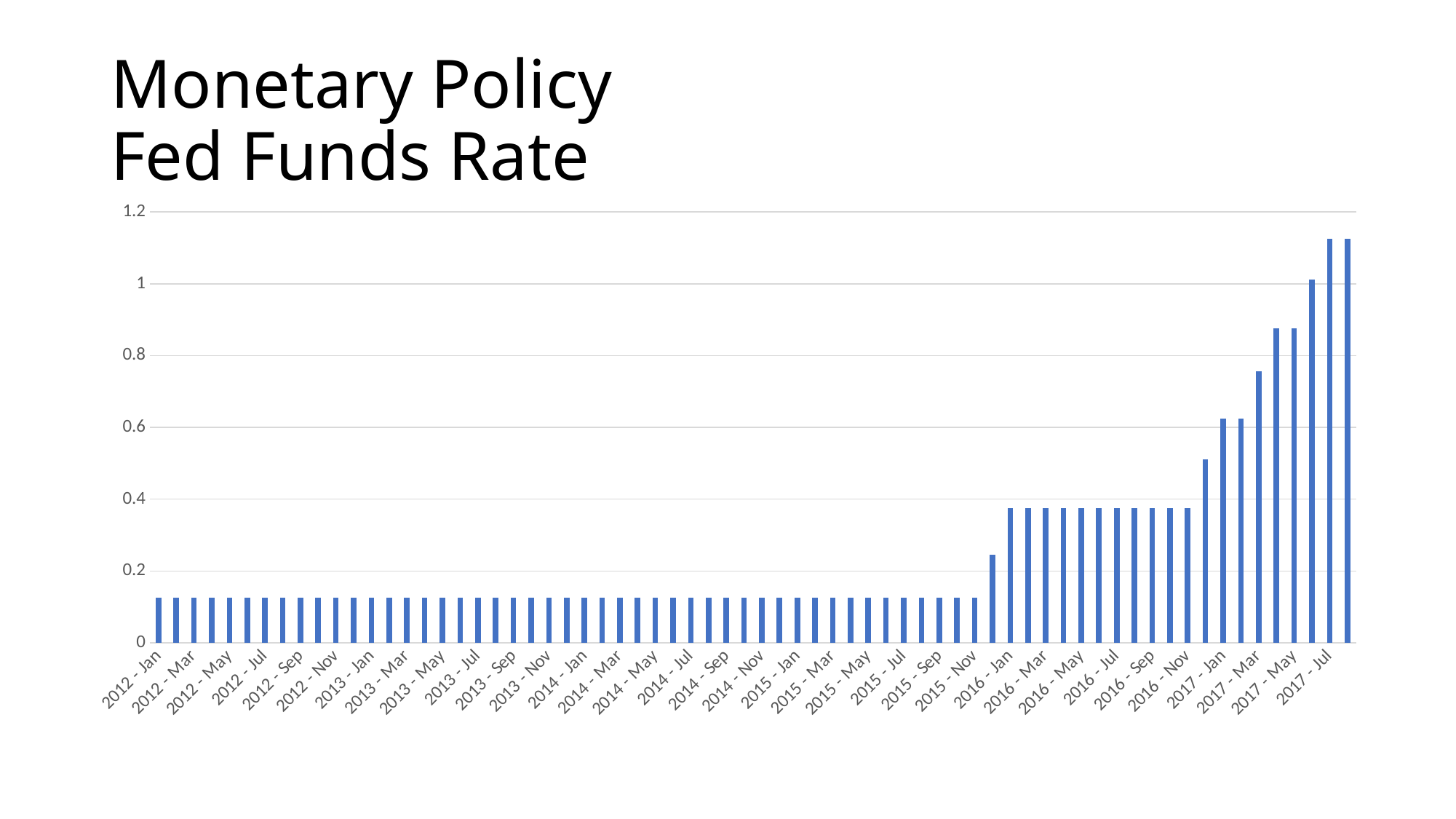
Is the value for 2017 - Mar greater or less than 0.6? greater Is the value for 2012 - Jan greater or less than 0.2? less Which is larger, the value for 2012 - Jan or the value for 2016 - Mar? 2016 - Mar What is the title of the slide containing the chart? Monetary Policy Fed Funds Rate Is the value for 2017 - May greater or less than 0.8? greater Do the values generally rise or fall from 2012 - Jan to 2017 - Jul? rise What kind of chart is shown on the slide? bar chart What is the highest value shown on the vertical axis? 1.2 Which is larger, the value for 2017 - Jan or the value for 2016 - Jan? 2017 - Jan